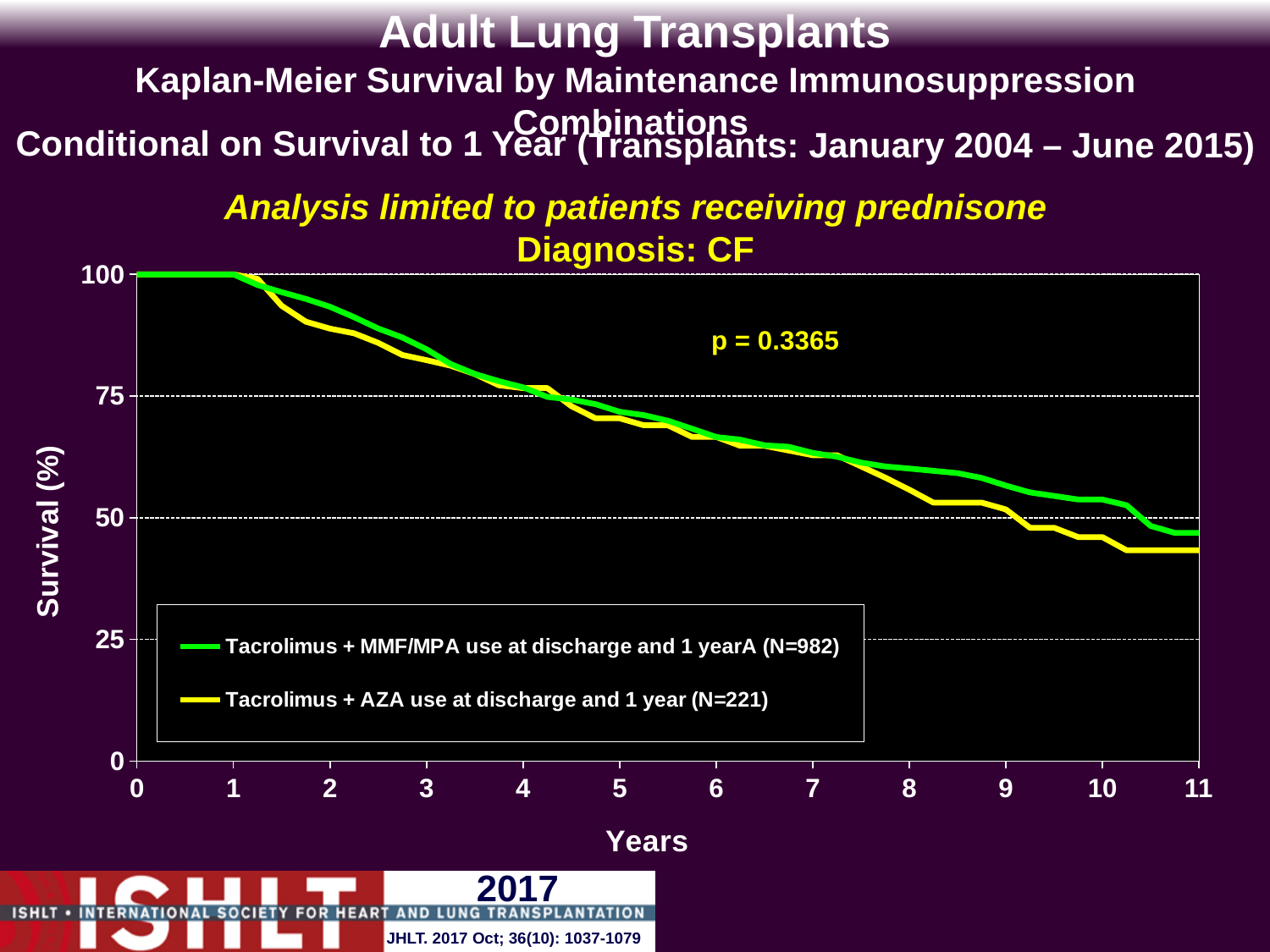
Do the survival curves rise or fall as years increase? fall What is the N for the Tacrolimus + AZA use at discharge and 1 year group? N=221 How many series does the legend list? 2 At year 2, which group has higher survival: Tacrolimus + MMF/MPA or Tacrolimus + AZA? Tacrolimus + MMF/MPA What kind of chart is shown on the slide? line chart What is the label of the y axis? Survival (%) What is the N for the Tacrolimus + MMF/MPA use at discharge and 1 year group? N=982 Is the survival for the Tacrolimus + MMF/MPA group at year 3 greater or less than 75? greater Is the survival for the Tacrolimus + AZA group at year 10 greater or less than 50? less What is the p-value printed on the chart? p = 0.3365 At year 10, which group has higher survival: Tacrolimus + MMF/MPA or Tacrolimus + AZA? Tacrolimus + MMF/MPA